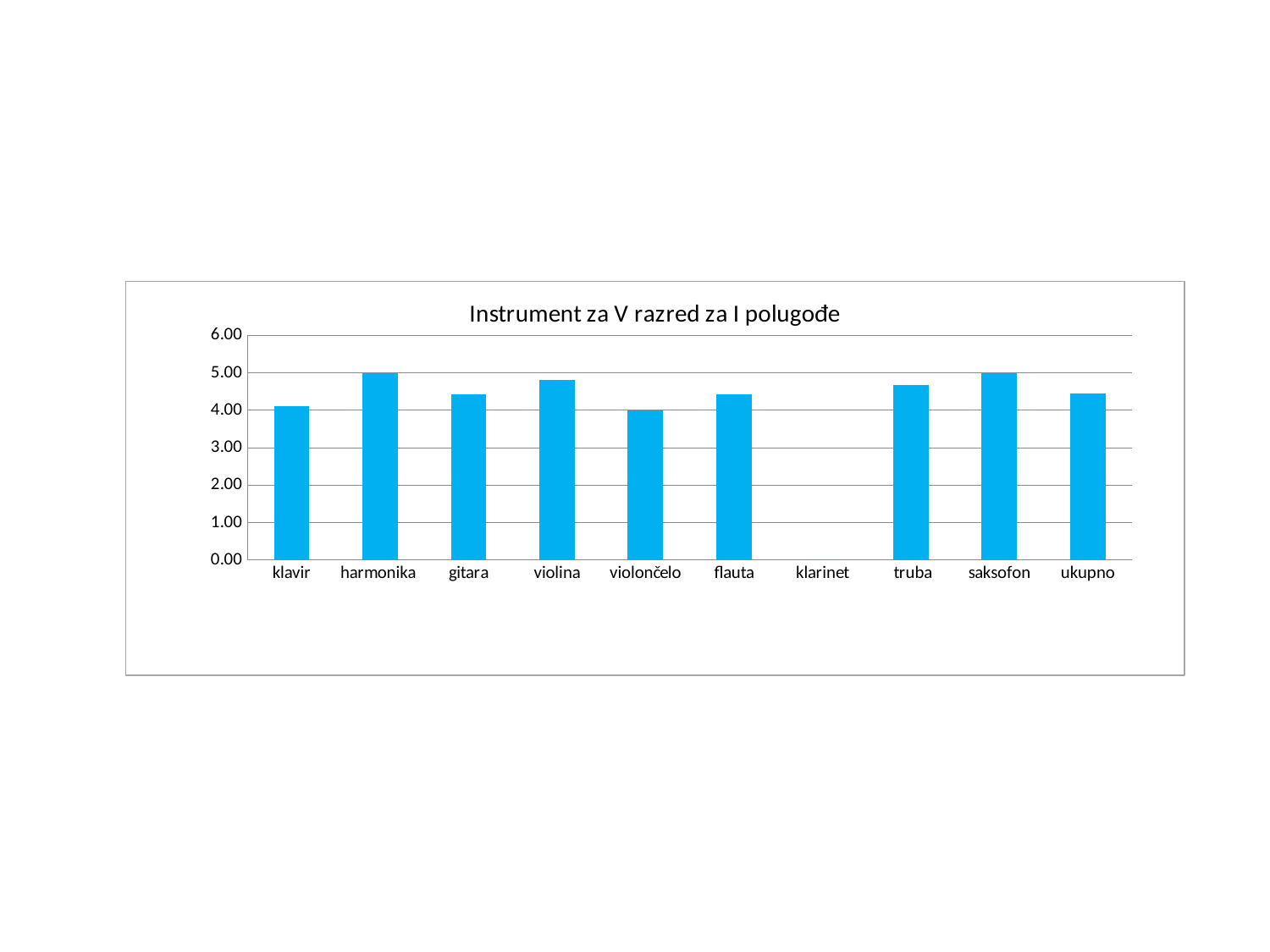
Which has the larger value, violina or gitara? violina Is the value for gitara greater or less than 3.00? greater Is the value for violina greater or less than 5.00? less Which category on the chart has no visible bar? klarinet What kind of chart is shown on the slide? bar chart Is the value for harmonika greater or less than 4.00? greater Which has the larger value, truba or klavir? truba What colour are the bars in the chart? blue How many categories are shown on the x axis of the chart? 10 What is the title of the chart? Instrument za V razred za I polugođe